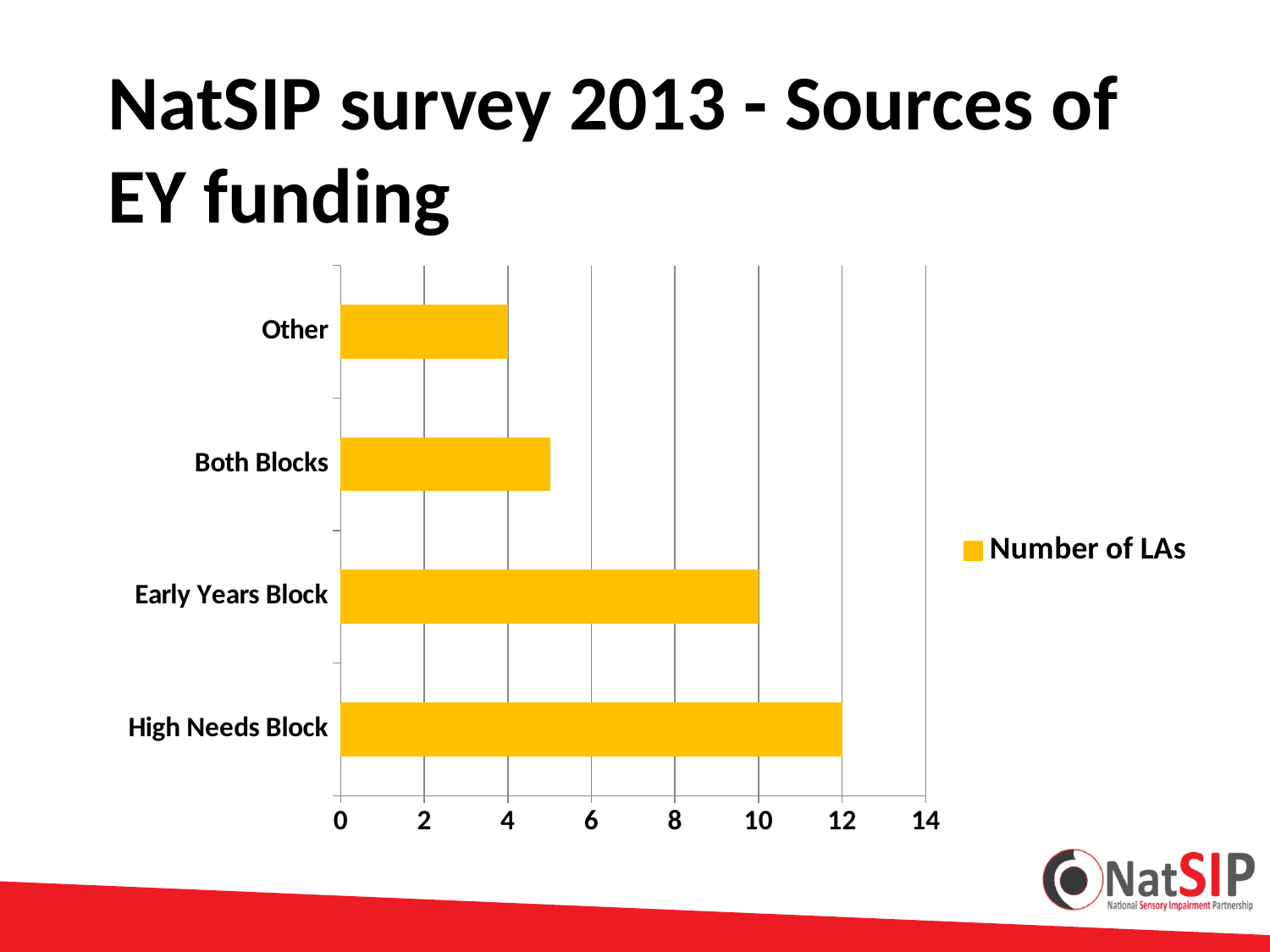
What is the difference between the values for High Needs Block and Early Years Block? 2 Which is larger, the value for Both Blocks or the value for Early Years Block? Early Years Block How many series does the legend list? 1 What kind of chart is shown on the slide? bar chart Which category has the highest number of LAs? High Needs Block What is the value for Other? 4 What is the value for Early Years Block? 10 Which category has the lowest number of LAs? Other What is the value for High Needs Block? 12 How many categories are shown on the chart? 4 Is the value for Both Blocks greater or less than 6? less What is the difference between the values for Early Years Block and Other? 6